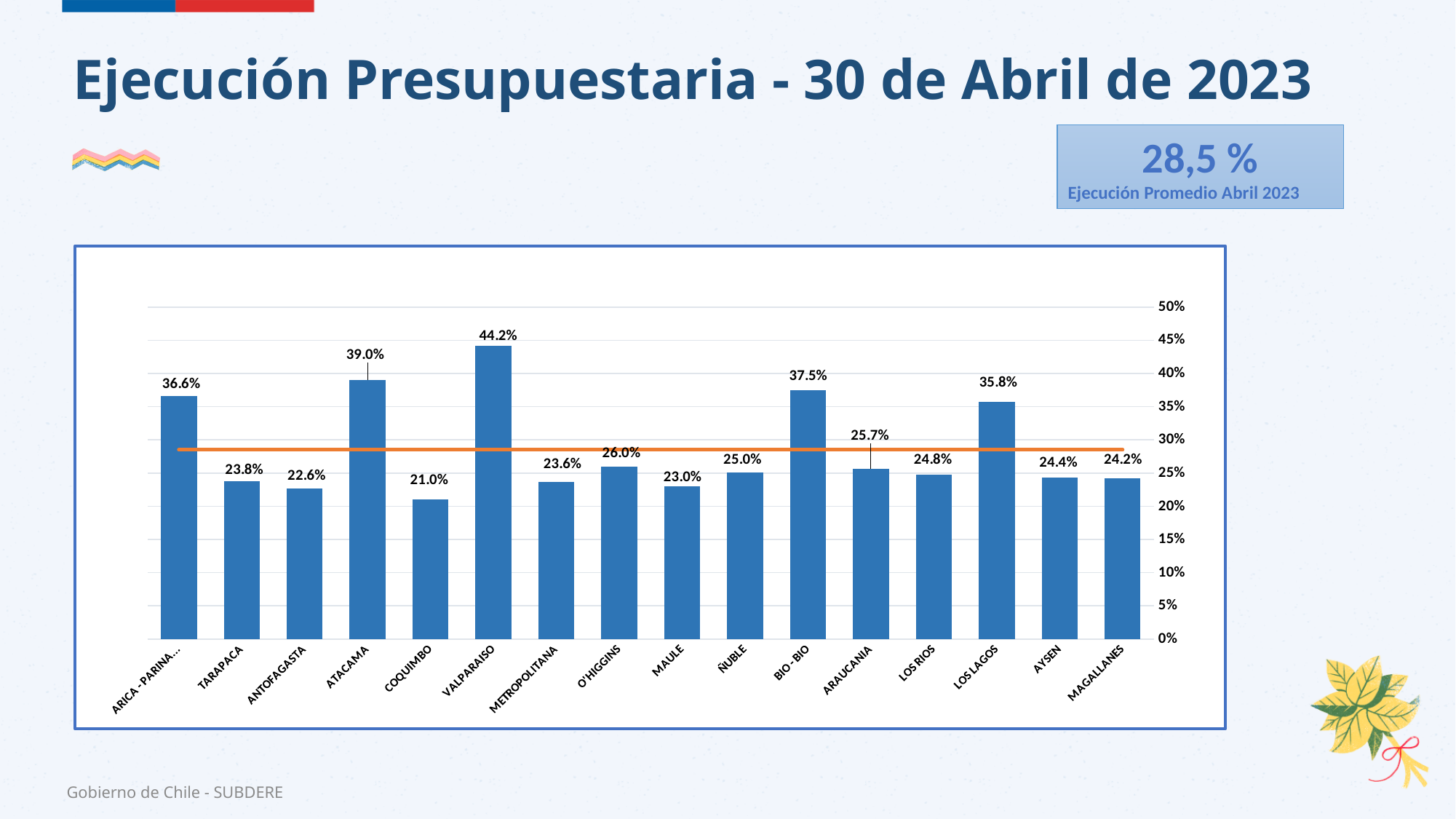
What is the maximum value shown on the vertical axis? 50% What is the value for O'HIGGINS? 26.0% What is the value for VALPARAISO? 44.2% What is the value for COQUIMBO? 21.0% Which region has the highest value? VALPARAISO What is the value for BIO - BIO? 37.5% What kind of chart is shown on the slide? combination bar and line chart How many regions are shown on the x axis? 16 What is the difference between the values for ATACAMA and TARAPACA? 15.2% Is the value for MAGALLANES greater or less than 30%? less Which region has the lowest value? COQUIMBO Which is larger, the value for LOS LAGOS or the value for ARAUCANIA? LOS LAGOS